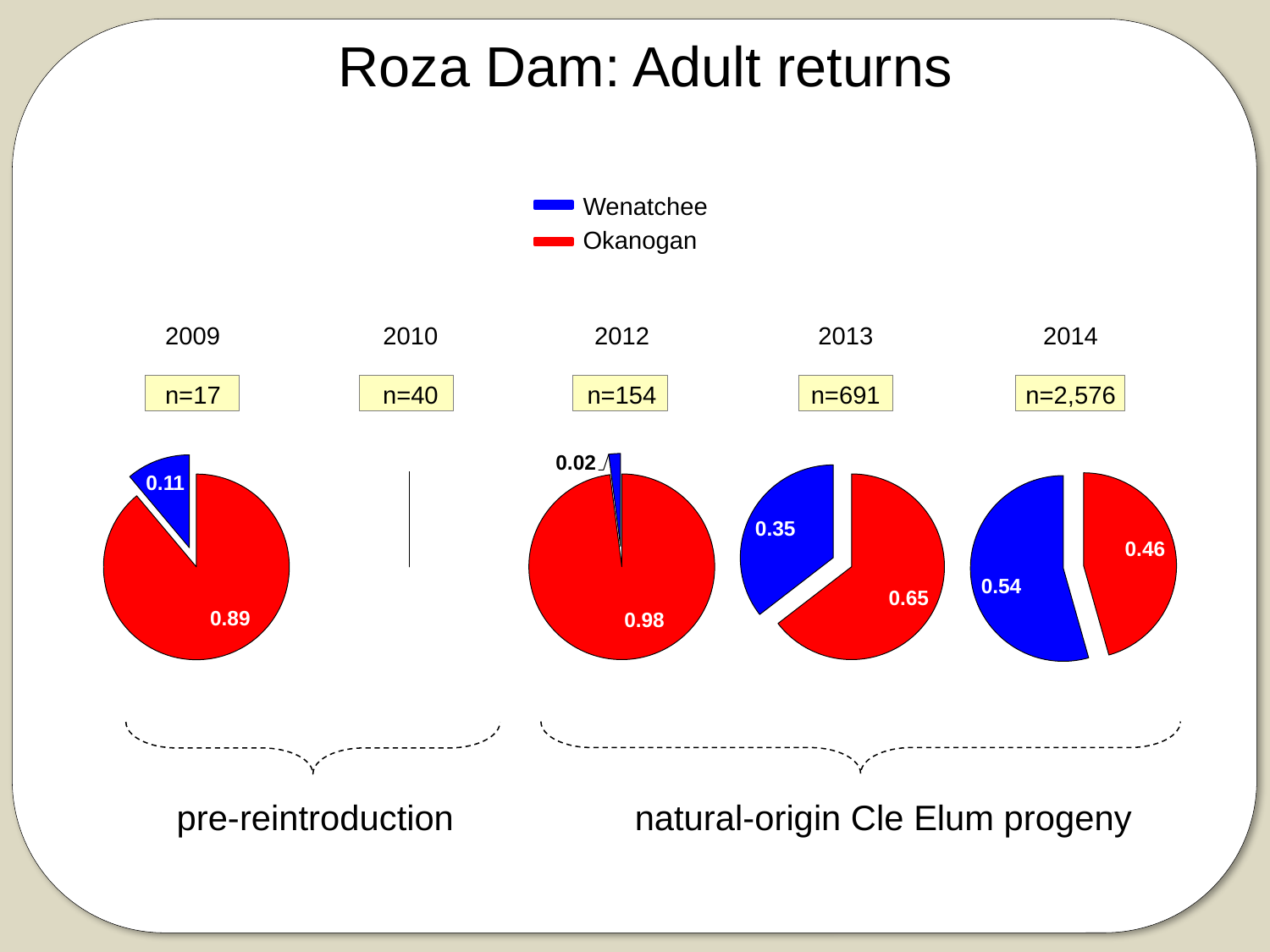
What kind of chart is used to show the adult returns for each year? Pie chart In the 2013 pie chart, what share is labelled for Okanogan? 0.65 In the 2009 pie chart, what share is labelled for Wenatchee? 0.11 In the 2014 pie chart, what share is labelled for Wenatchee? 0.54 In the 2012 pie chart, what share is labelled for Wenatchee? 0.02 In the 2014 pie chart, which slice is larger, Wenatchee or Okanogan? Wenatchee In the 2009 pie chart, what share is labelled for Okanogan? 0.89 Which colour represents Okanogan in the legend? Red In the 2013 pie chart, what is the difference between the Okanogan share and the Wenatchee share? 0.30 In the 2013 pie chart, which slice is larger, Wenatchee or Okanogan? Okanogan What is the sample size (n) shown above the 2014 pie chart? n=2,576 How many series does the legend list? 2